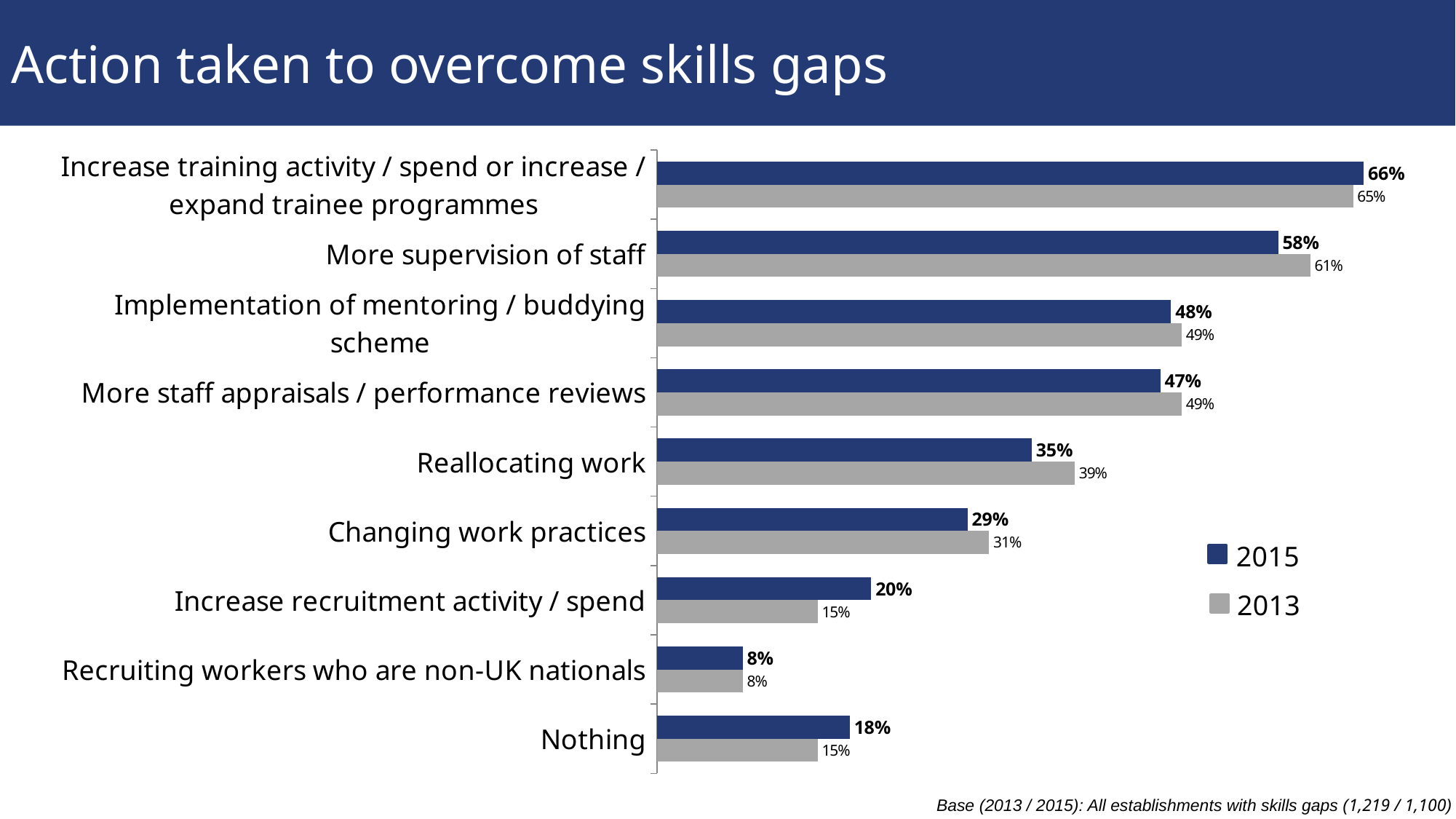
What is the 2015 value for 'Nothing'? 18% What is the difference between the 2015 values for 'More supervision of staff' and 'Reallocating work'? 23% Which category has the highest 2015 value? Increase training activity / spend or increase / expand trainee programmes What is the 2013 value for 'Reallocating work'? 39% What kind of chart is shown on the slide? Bar chart How many categories are shown on the chart? 9 What is the title of the slide? Action taken to overcome skills gaps What is the 2015 value for 'More supervision of staff'? 58% How many series does the legend list? 2 Which category has the lowest 2013 value? Recruiting workers who are non-UK nationals What is the difference between the 2013 and 2015 values for 'Increase recruitment activity / spend'? 5% For 'Changing work practices', which year has the larger value, 2015 or 2013? 2013